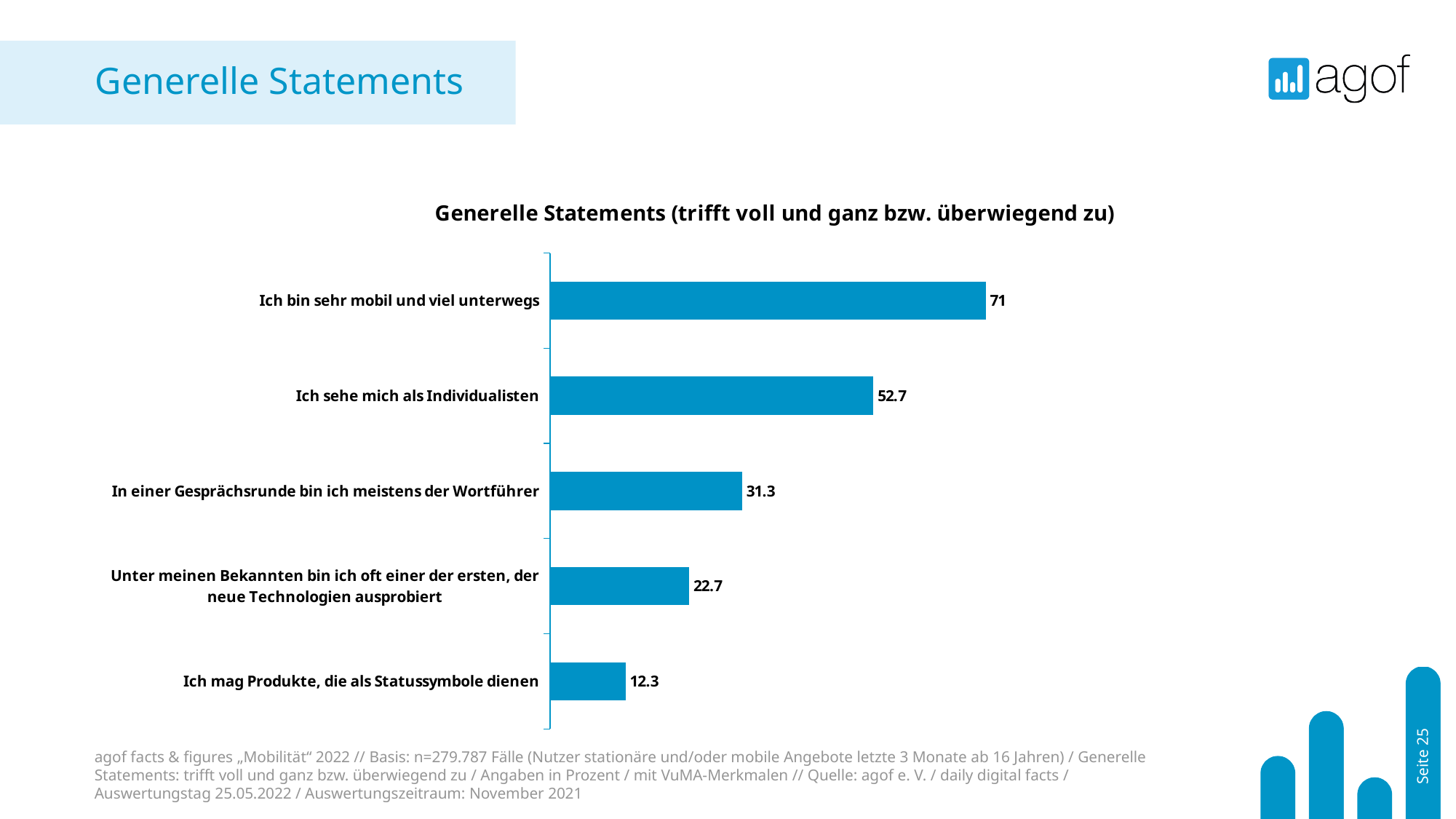
Which statement has the highest value? Ich bin sehr mobil und viel unterwegs What is the value for "In einer Gesprächsrunde bin ich meistens der Wortführer"? 31.3 What is the difference between the values for "In einer Gesprächsrunde bin ich meistens der Wortführer" and "Unter meinen Bekannten bin ich oft einer der ersten, der neue Technologien ausprobiert"? 8.6 What is the value for "Ich sehe mich als Individualisten"? 52.7 Which is larger: the value for "Unter meinen Bekannten bin ich oft einer der ersten, der neue Technologien ausprobiert" or for "Ich mag Produkte, die als Statussymbole dienen"? Unter meinen Bekannten bin ich oft einer der ersten, der neue Technologien ausprobiert What kind of chart is shown on the slide? Bar chart How many statements are shown in the chart? 5 Which statement has the lowest value? Ich mag Produkte, die als Statussymbole dienen What is the value for "Ich mag Produkte, die als Statussymbole dienen"? 12.3 What is the difference between the values for "Ich bin sehr mobil und viel unterwegs" and "Ich sehe mich als Individualisten"? 18.3 What is the value for "Ich bin sehr mobil und viel unterwegs"? 71 What is the title of the chart? Generelle Statements (trifft voll und ganz bzw. überwiegend zu)